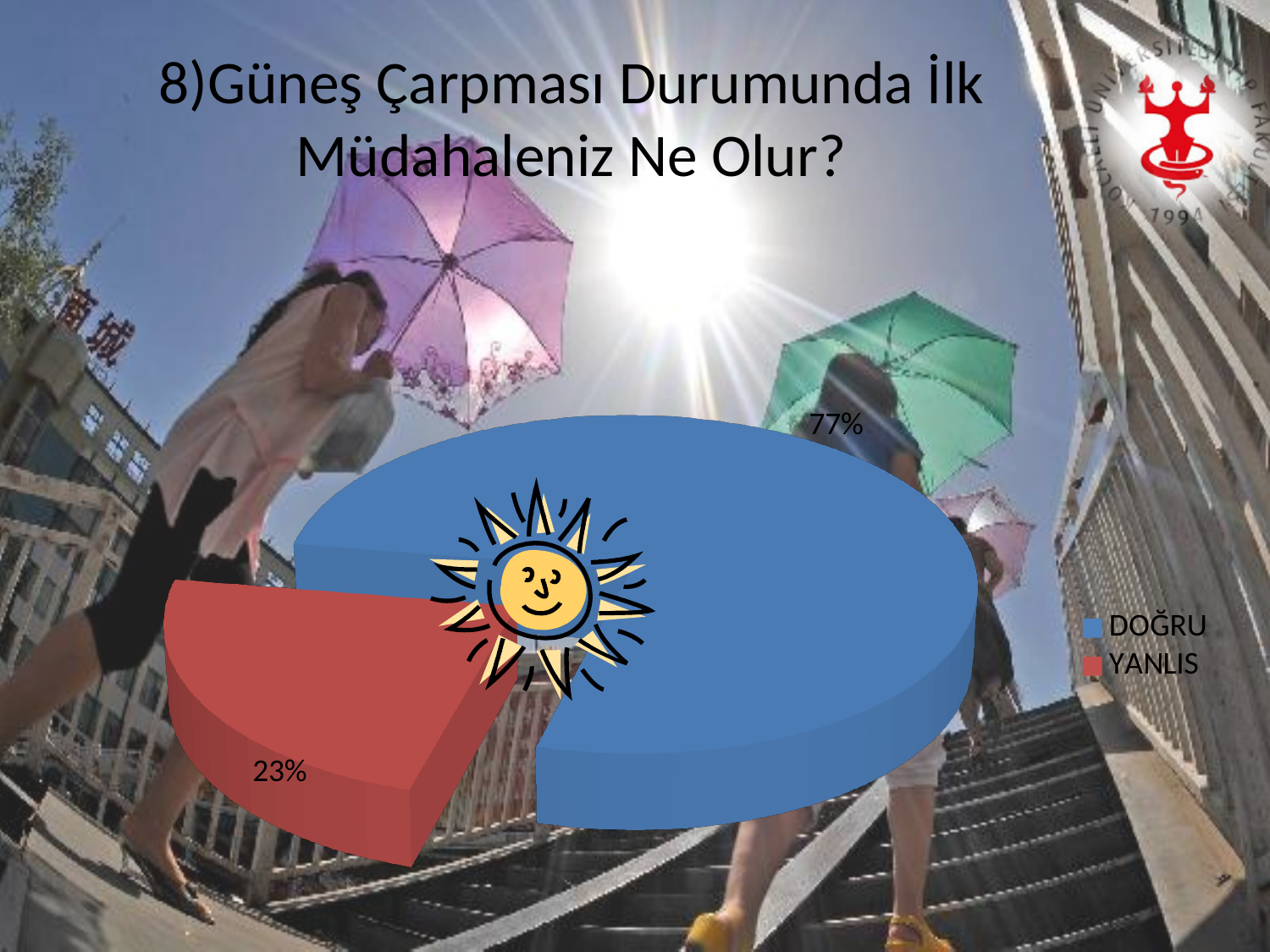
What percentage of the pie is DOĞRU? 77% What colour is the YANLIS slice? red Which is larger, DOĞRU or YANLIS? DOĞRU What kind of chart is shown on the slide? pie chart Which slice is the smallest? YANLIS What share of the pie does the YANLIS slice take? 23% What percentage of the pie is YANLIS? 23% What is the difference in percentage points between DOĞRU and YANLIS? 54 Which slice is the largest? DOĞRU How many entries does the legend list? 2 What colour is the DOĞRU slice? blue How many slices does the pie chart have? 2